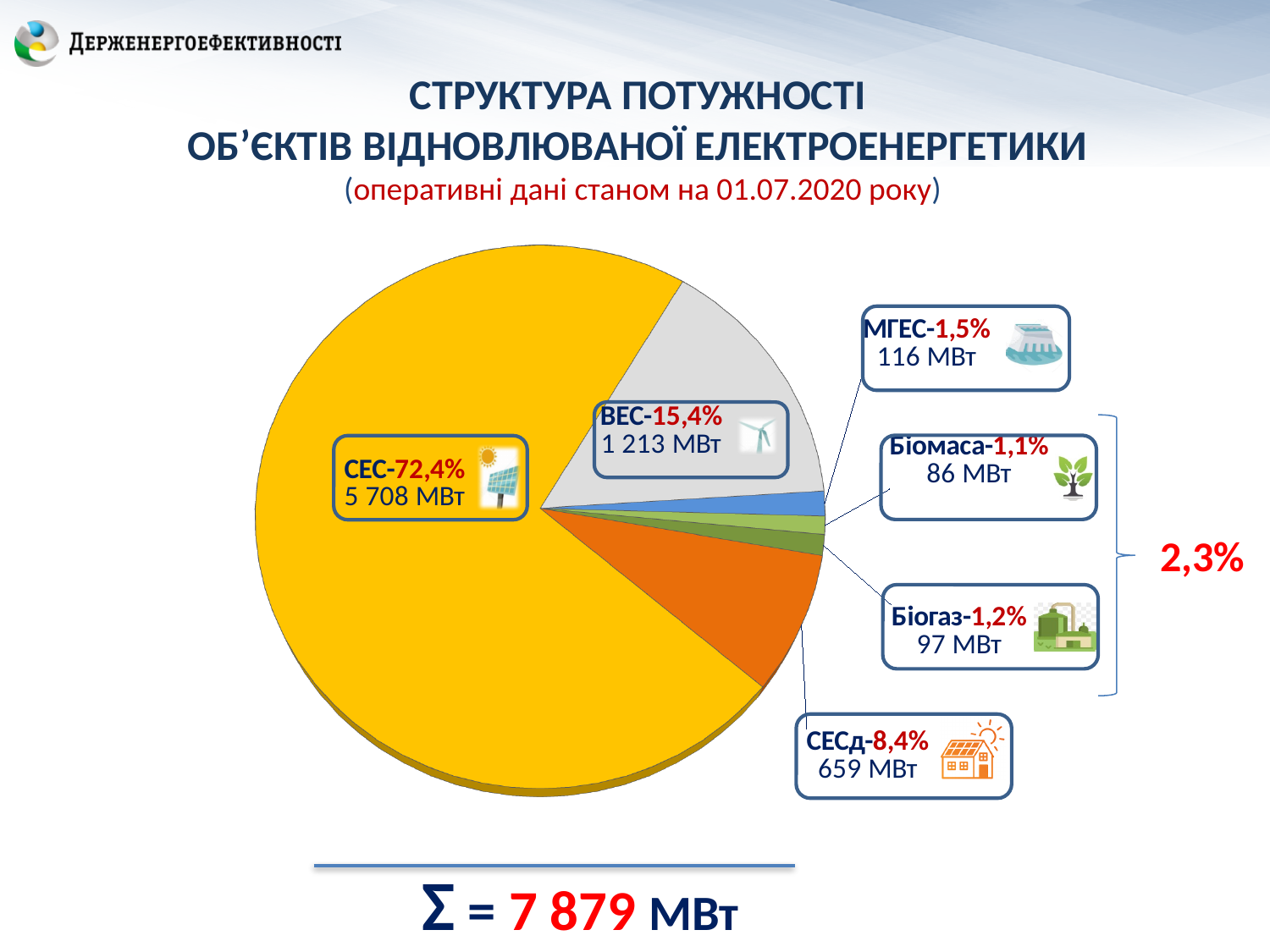
What combined share is shown by the bracket grouping Біомаса and Біогаз? 2,3% What is the capacity shown for МГЕС? 116 МВт Which category has the smallest slice of the pie? Біомаса What share of the pie does СЕСд have? 8,4% What is the capacity shown for СЕС? 5 708 МВт Which category has the largest slice of the pie? СЕС What type of chart is shown on the slide? pie chart How many slices does the pie chart have? 6 What is the difference in capacity between Біогаз and Біомаса? 11 МВт What is the total capacity (Σ) shown below the chart? 7 879 МВт What share of the pie does ВЕС have? 15,4% Which has a larger capacity, ВЕС or СЕСд? ВЕС